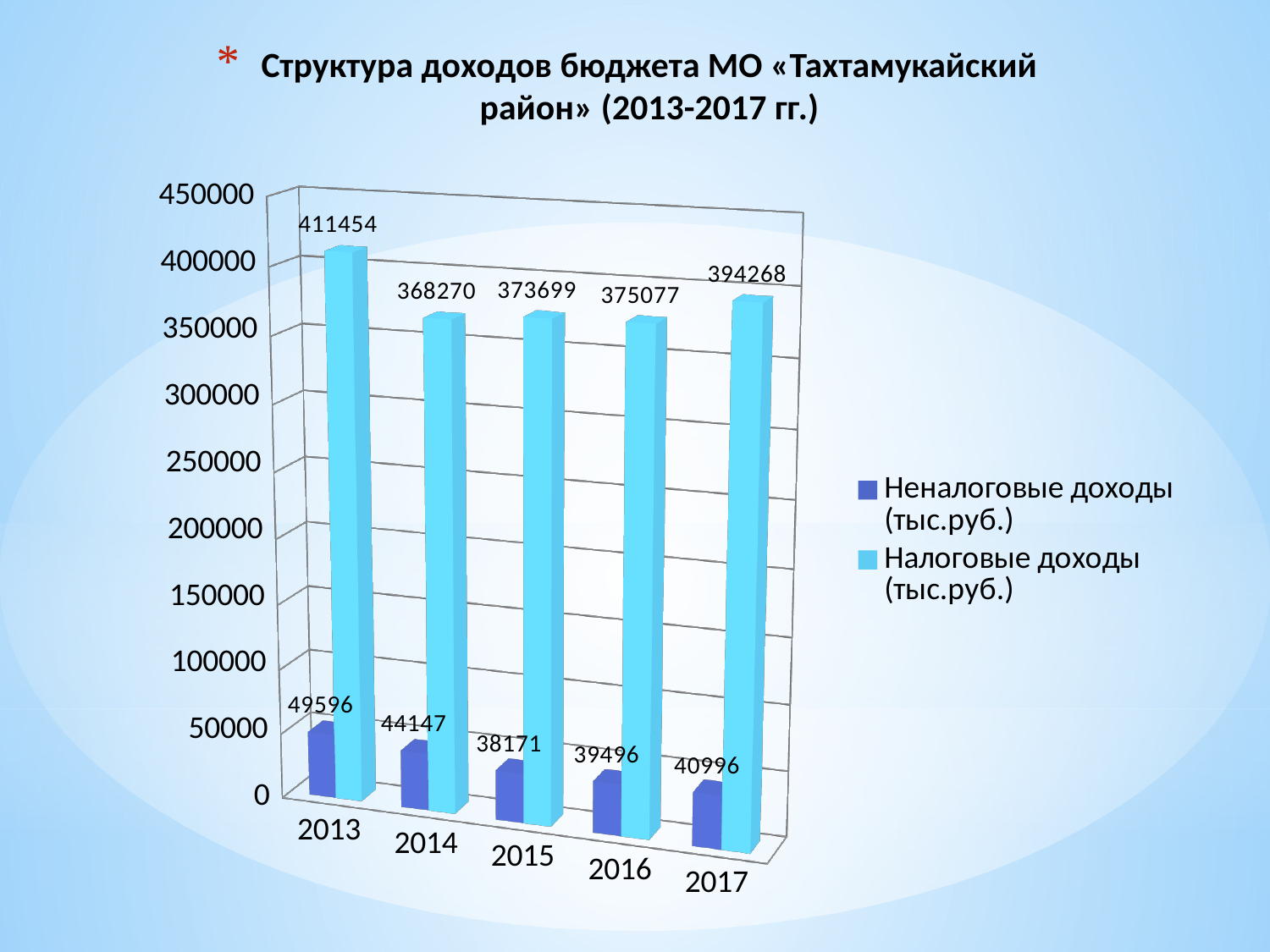
Do the values of Налоговые доходы (тыс.руб.) rise or fall from 2014 to 2017? rise How many years are shown on the x axis? 5 What is the value of Неналоговые доходы (тыс.руб.) for 2015? 38171 Is the value of Налоговые доходы (тыс.руб.) for 2016 greater or less than 350000? greater Which year has the lowest Неналоговые доходы (тыс.руб.)? 2015 How many series does the legend list? 2 Which year has the highest Налоговые доходы (тыс.руб.)? 2013 What kind of chart is shown on the slide? bar chart What is the value of Налоговые доходы (тыс.руб.) for 2017? 394268 Which is larger: Неналоговые доходы (тыс.руб.) in 2016 or in 2017? 2017 What is the difference between Налоговые доходы (тыс.руб.) in 2013 and 2014? 43184 What is the value of Налоговые доходы (тыс.руб.) for 2013? 411454